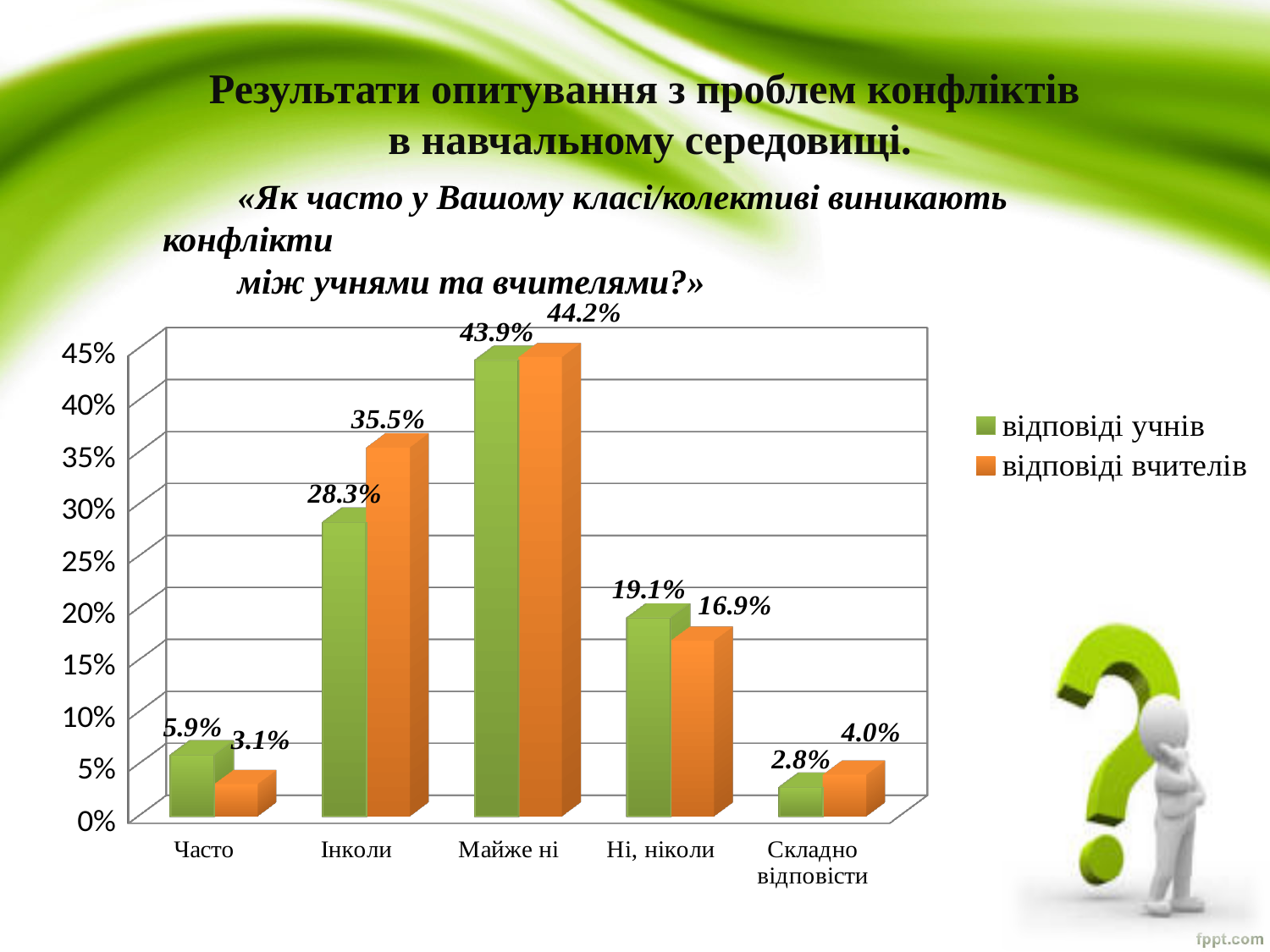
What kind of chart is shown on the slide? bar chart In the "Ні, ніколи" category, which series has the larger value, "відповіді учнів" or "відповіді вчителів"? відповіді учнів What is the value for "відповіді учнів" in the "Інколи" category? 28.3% Which category has the highest value for "відповіді учнів"? Майже ні What is the difference between "відповіді вчителів" and "відповіді учнів" in the "Інколи" category? 7.2% Which colour represents "відповіді вчителів" in the chart? orange What is the value for "відповіді вчителів" in the "Часто" category? 3.1% What is the value for "відповіді вчителів" in the "Майже ні" category? 44.2% What is the value for "відповіді учнів" in the "Складно відповісти" category? 2.8% How many series does the legend list? 2 Which category has the lowest value for "відповіді вчителів"? Часто How many categories are shown on the x axis? 5